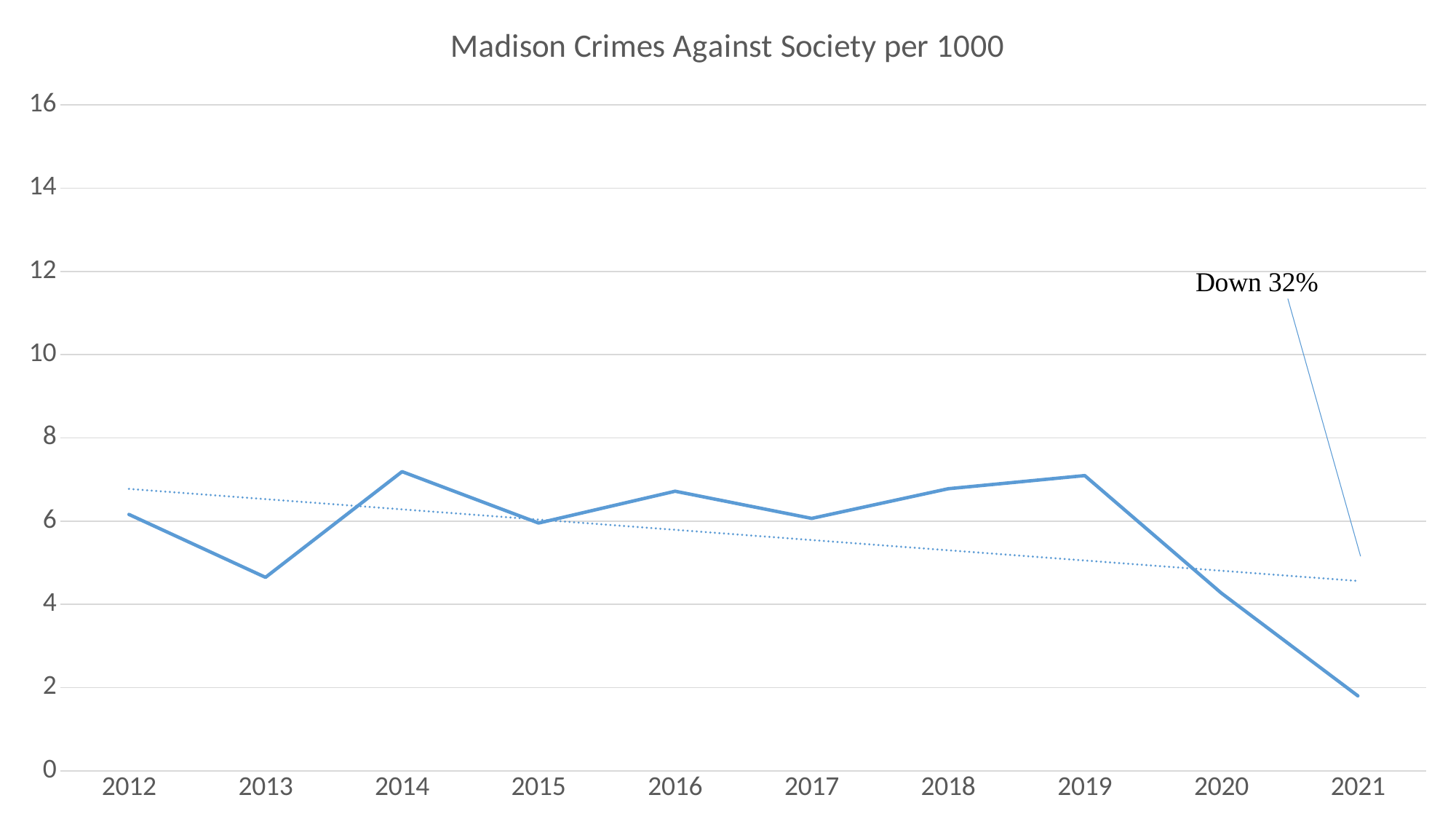
Which year has the larger value, 2019 or 2020? 2019 Which year has the larger value, 2013 or 2014? 2014 Is the value for 2020 greater or less than 6? less Is the value for 2014 greater or less than 6? greater Does the value rise or fall from 2019 to 2021? fall What is the title of the chart? Madison Crimes Against Society per 1000 Which year has the lowest value? 2021 What does the text annotation near the end of the line say? Down 32% Is the value for 2021 greater or less than 2? less What type of chart is shown on the slide? line chart How many years are plotted along the x axis? 10